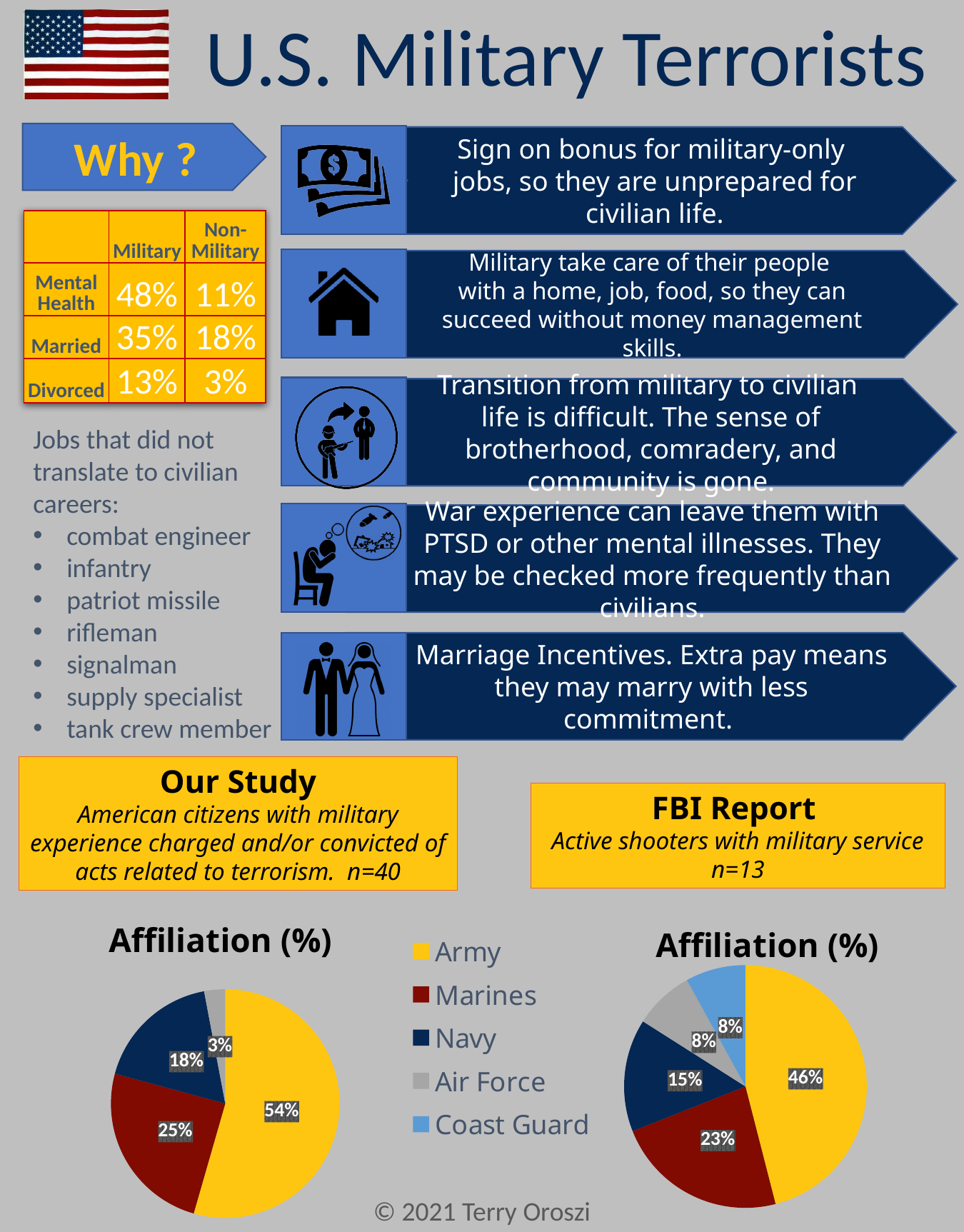
How many slices does the right pie chart (under FBI Report) have? 5 In the right pie chart (under FBI Report), what share does Coast Guard have? 8% In the left pie chart (under Our Study), which affiliation has the largest slice? Army In the right pie chart (under FBI Report), which affiliation has the largest slice? Army In the left pie chart (under Our Study), which is larger, the Marines slice or the Navy slice? Marines In the right pie chart (under FBI Report), what share does Navy have? 15% What type of chart is used under the Our Study heading? Pie chart How many entries does the legend between the two pie charts list? 5 In the left pie chart (under Our Study), which affiliation has the smallest slice? Air Force In the left pie chart (under Our Study), what share does Army have? 54% In the right pie chart (under FBI Report), what is the difference between the Army and Marines shares? 23% In the left pie chart (under Our Study), what share does Marines have? 25%